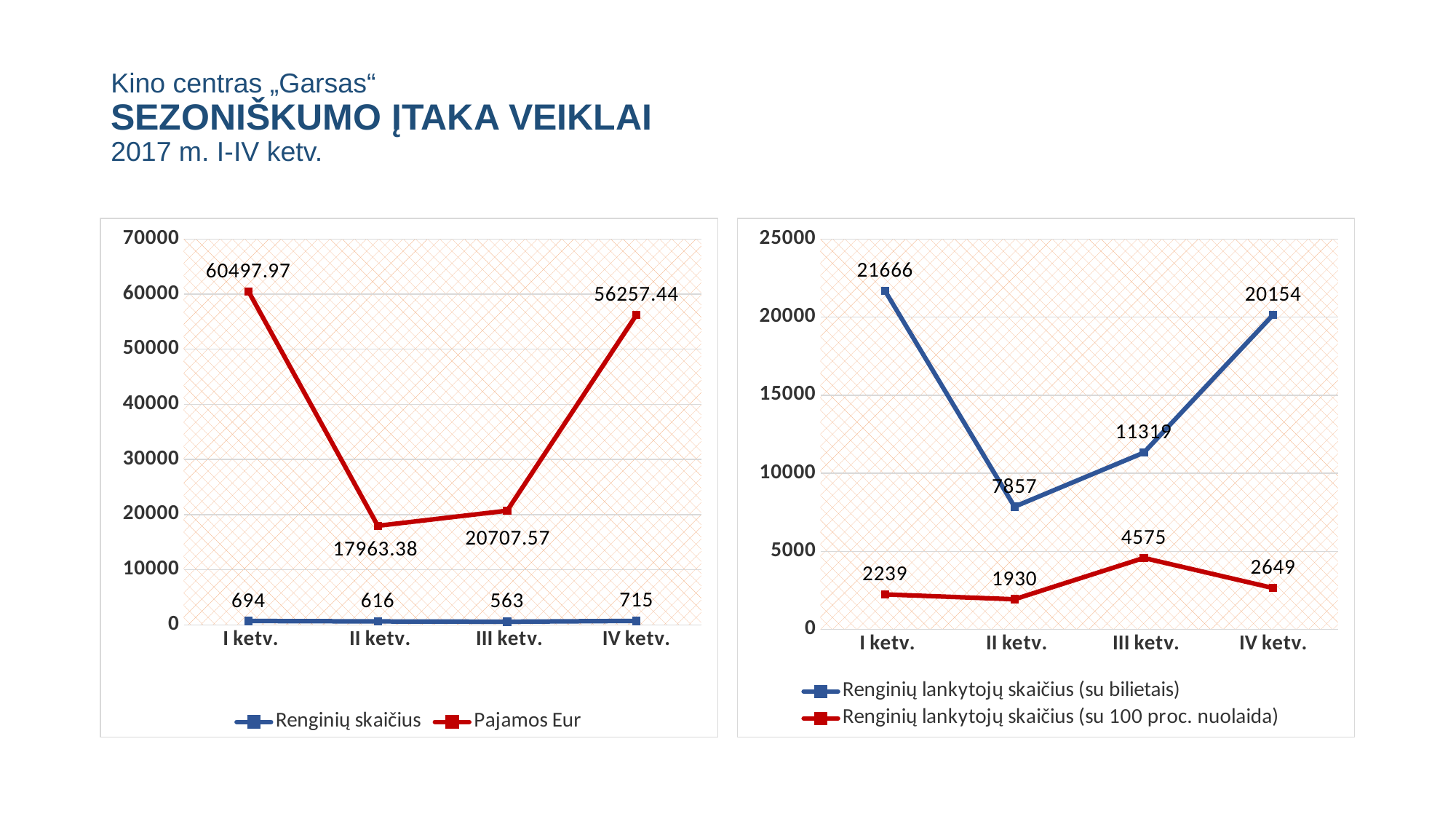
What type of chart is the right chart? Line chart In the left chart, how many series does the legend list? 2 In the left chart, which quarter has the lowest Pajamos Eur? II ketv. In the left chart, what is the difference between Renginių skaičius in I ketv. and II ketv.? 78 In the right chart, how many quarters are shown on the x axis? 4 In the left chart, which quarter has the highest Renginių skaičius? IV ketv. In the right chart, what is the value of Renginių lankytojų skaičius (su bilietais) for II ketv.? 7857 In the right chart, which quarter has the highest Renginių lankytojų skaičius (su bilietais)? I ketv. In the left chart, what is the value of Pajamos Eur for I ketv.? 60497.97 In the right chart, is Renginių lankytojų skaičius (su 100 proc. nuolaida) larger in I ketv. or IV ketv.? IV ketv. In the left chart, what is the value of Renginių skaičius for III ketv.? 563 In the right chart, what is the value of Renginių lankytojų skaičius (su 100 proc. nuolaida) for III ketv.? 4575